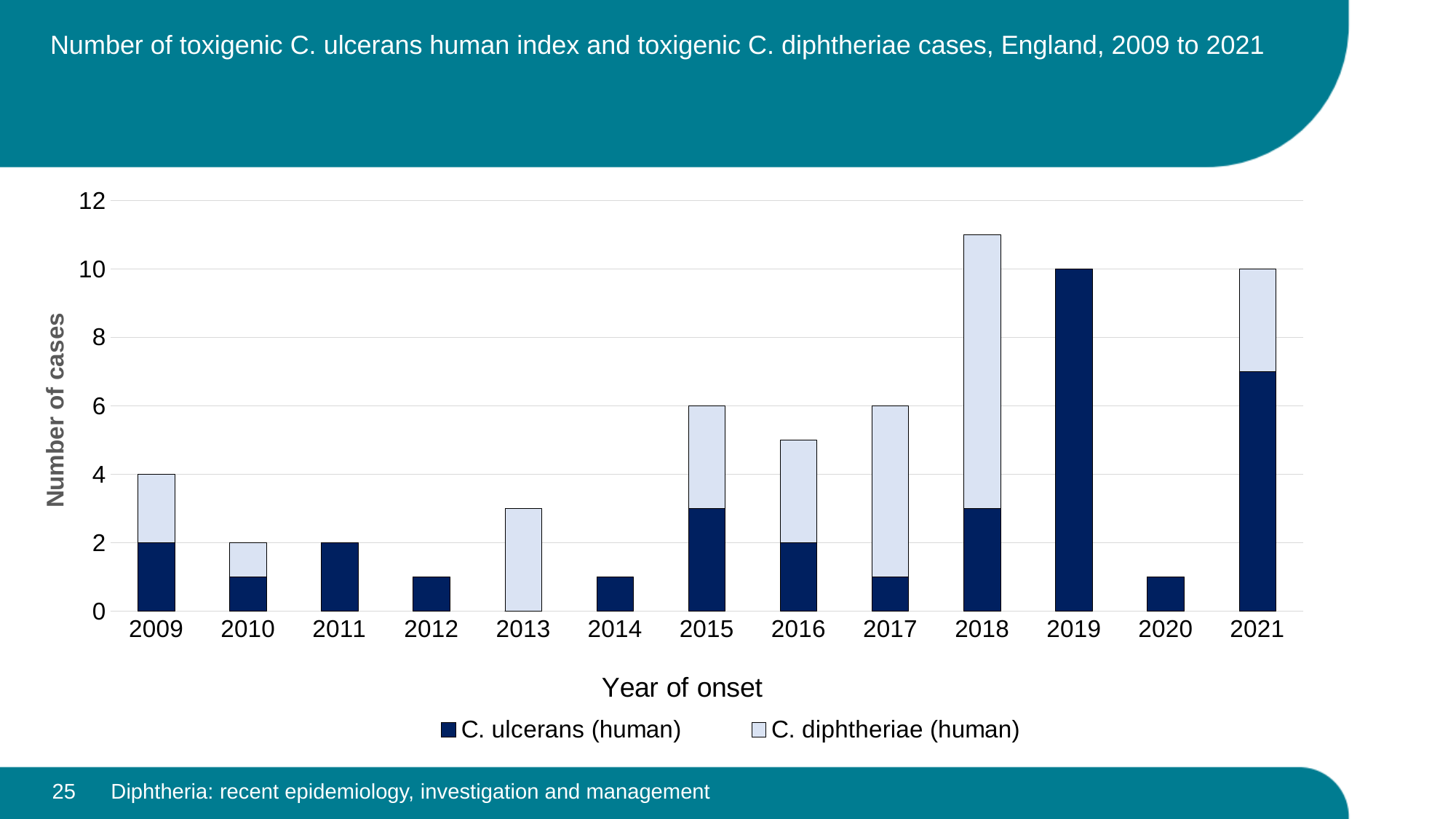
Is the number of C. ulcerans (human) cases in 2021 greater or less than 6? greater Is the total number of cases in 2018 greater or less than 10? greater Which year has more total cases, 2015 or 2010? 2015 Which year has the highest total number of cases? 2018 What type of chart is shown on the slide? Stacked bar chart How many series does the legend list? 2 What is the total number of cases in 2009? 4 What is the number of C. ulcerans (human) cases in 2011? 2 How many years are shown on the x axis? 13 What is the number of C. ulcerans (human) cases in 2019? 10 What is the total number of cases in 2021? 10 Which year has the highest number of C. ulcerans (human) cases? 2019